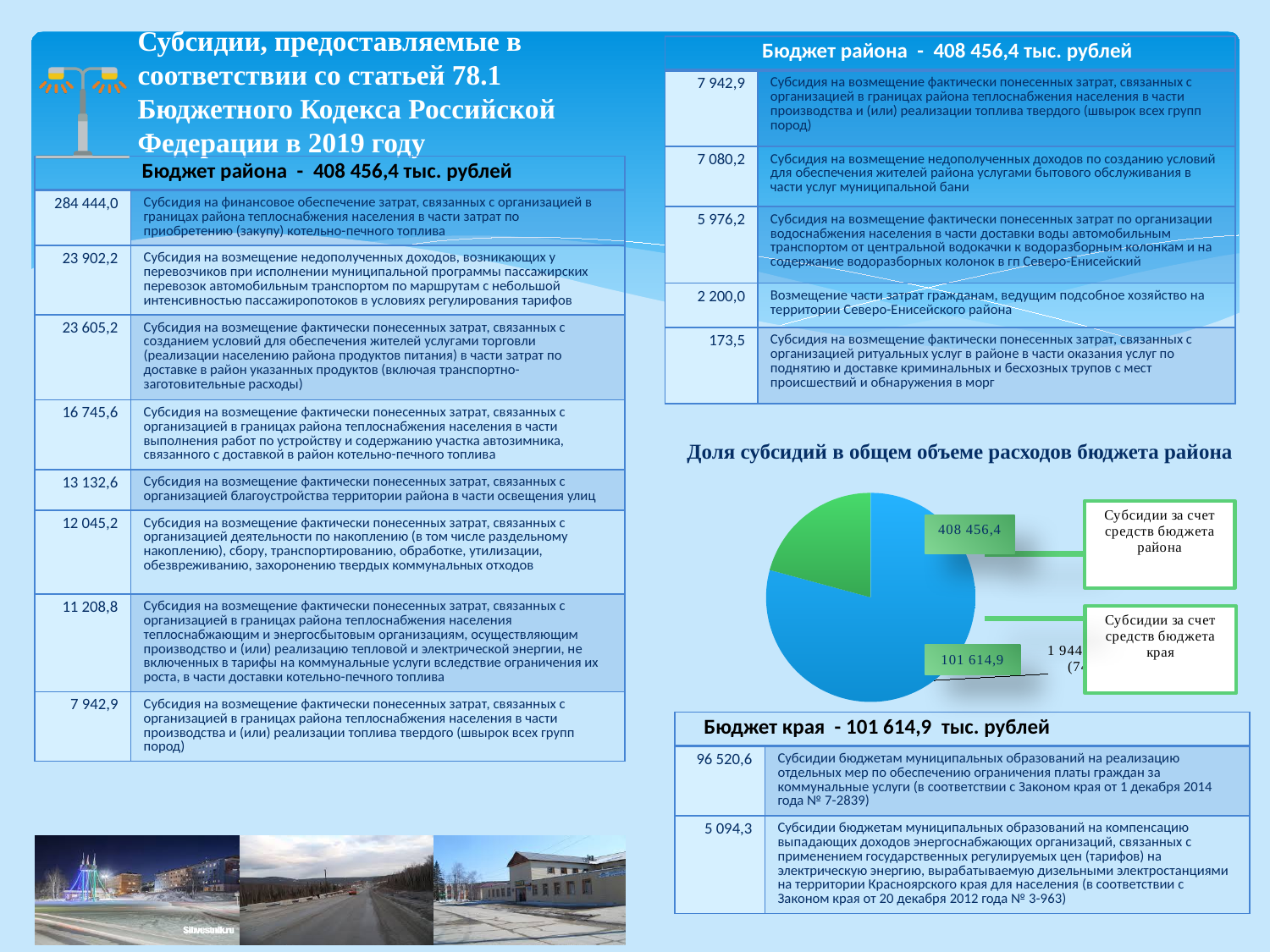
In the pie chart, which is larger: subsidies from the district budget (бюджета района) or subsidies from the regional budget (бюджета края)? Субсидии за счет средств бюджета района In the pie chart, what is the value for "Субсидии за счет средств бюджета края"? 101 614,9 In the pie chart, what is the value for "Субсидии за счет средств бюджета района"? 408 456,4 In the pie chart, what is the difference between the district budget subsidies (408 456,4) and the regional budget subsidies (101 614,9)? 306 841,5 What is the title of the pie chart on the slide? Доля субсидий в общем объеме расходов бюджета района What kind of chart is shown under the title "Доля субсидий в общем объеме расходов бюджета района"? pie chart